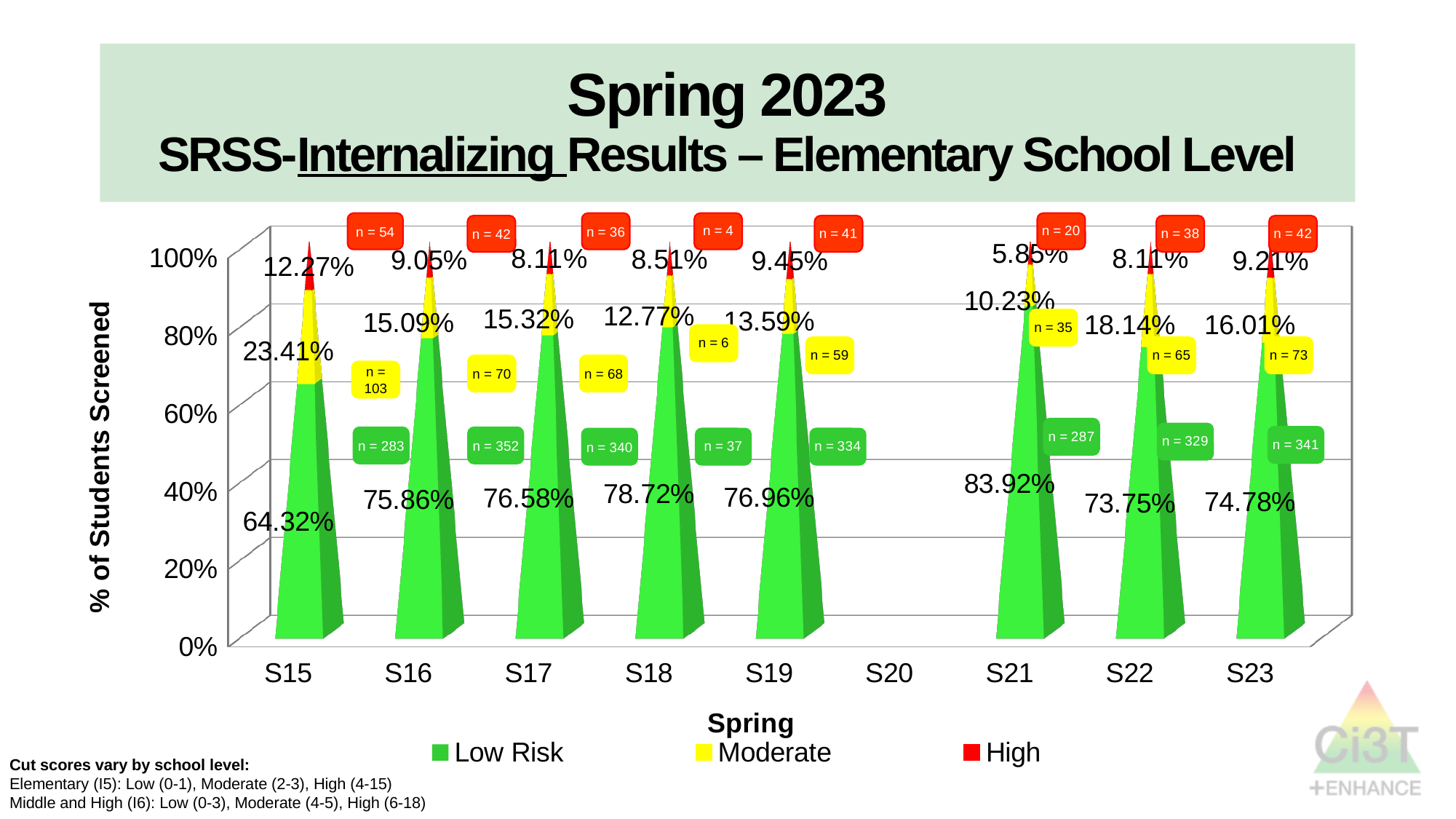
How many series does the legend list? 3 What is the difference between the Low Risk percentage in S21 and in S15? 19.60 percentage points Which spring term has the lowest High percentage? S21 What is the High value for S21? 5.85% What is the total of the three segments for S18? 100.00% Which has a larger Moderate percentage, S16 or S17? S17 What percentage of students screened were Low Risk in S15? 64.32% Which spring term has the highest Low Risk percentage? S21 Which spring term has the highest Moderate percentage? S15 What is the Moderate value for S22? 18.14% What is the n value shown for the Low Risk segment in S21? n = 287 How many spring terms are labelled on the x axis? 9